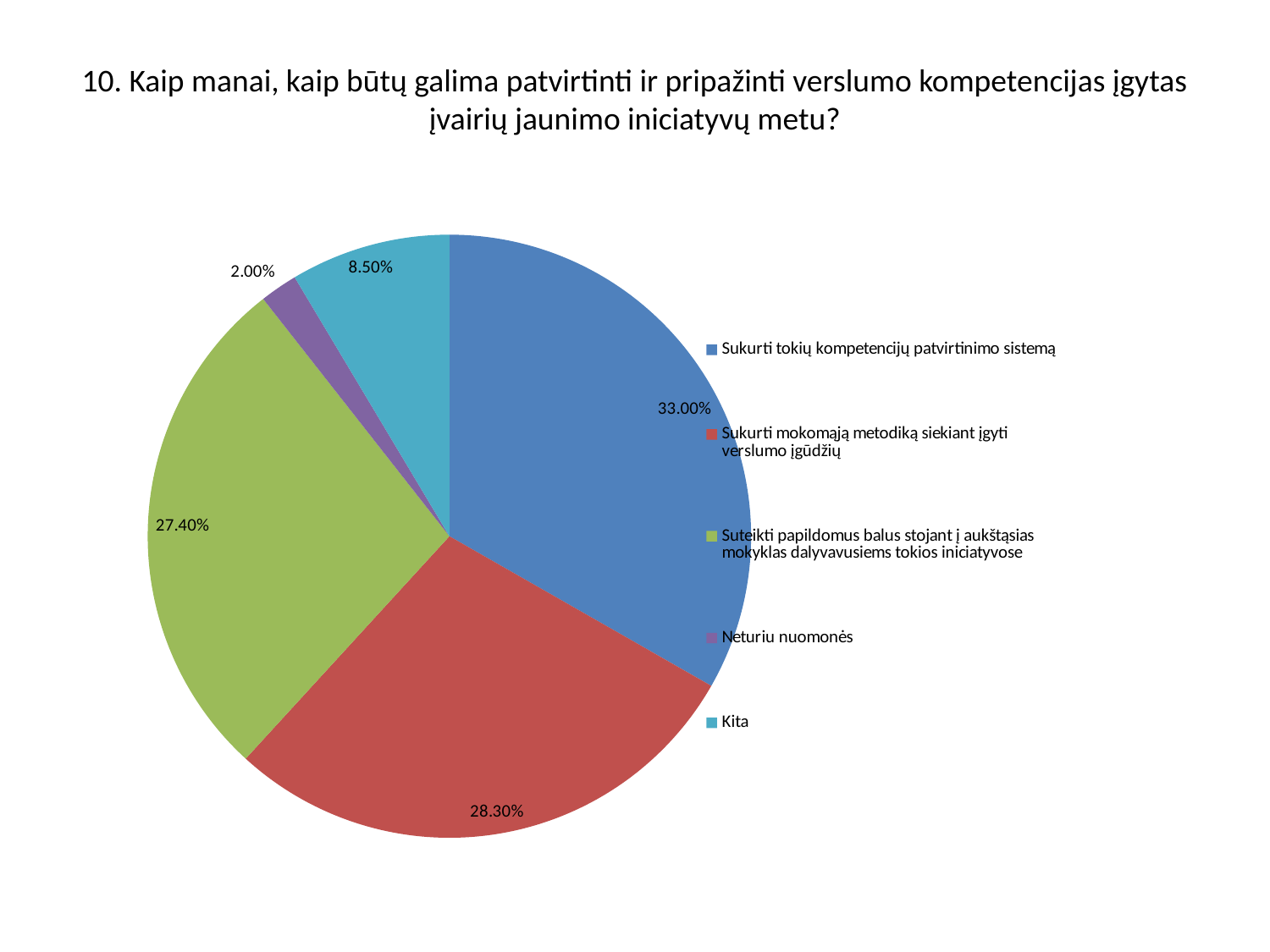
What is the value for "Sukurti mokomąją metodiką siekiant įgyti verslumo įgūdžių"? 28.30% What is the value for "Kita"? 8.50% What is the difference between the values for "Kita" and "Neturiu nuomonės"? 6.50% What kind of chart is shown on the slide? pie chart How many entries does the legend list? 5 How many slices does the pie chart have? 5 Which category has the largest share of the pie? Sukurti tokių kompetencijų patvirtinimo sistemą Which category has the smallest share of the pie? Neturiu nuomonės What is the value for "Suteikti papildomus balus stojant į aukštąsias mokyklas dalyvavusiems tokios iniciatyvose"? 27.40% What is the value for "Sukurti tokių kompetencijų patvirtinimo sistemą"? 33.00% What is the value for "Neturiu nuomonės"? 2.00% Which is larger, the value for "Sukurti mokomąją metodiką siekiant įgyti verslumo įgūdžių" or the value for "Kita"? Sukurti mokomąją metodiką siekiant įgyti verslumo įgūdžių